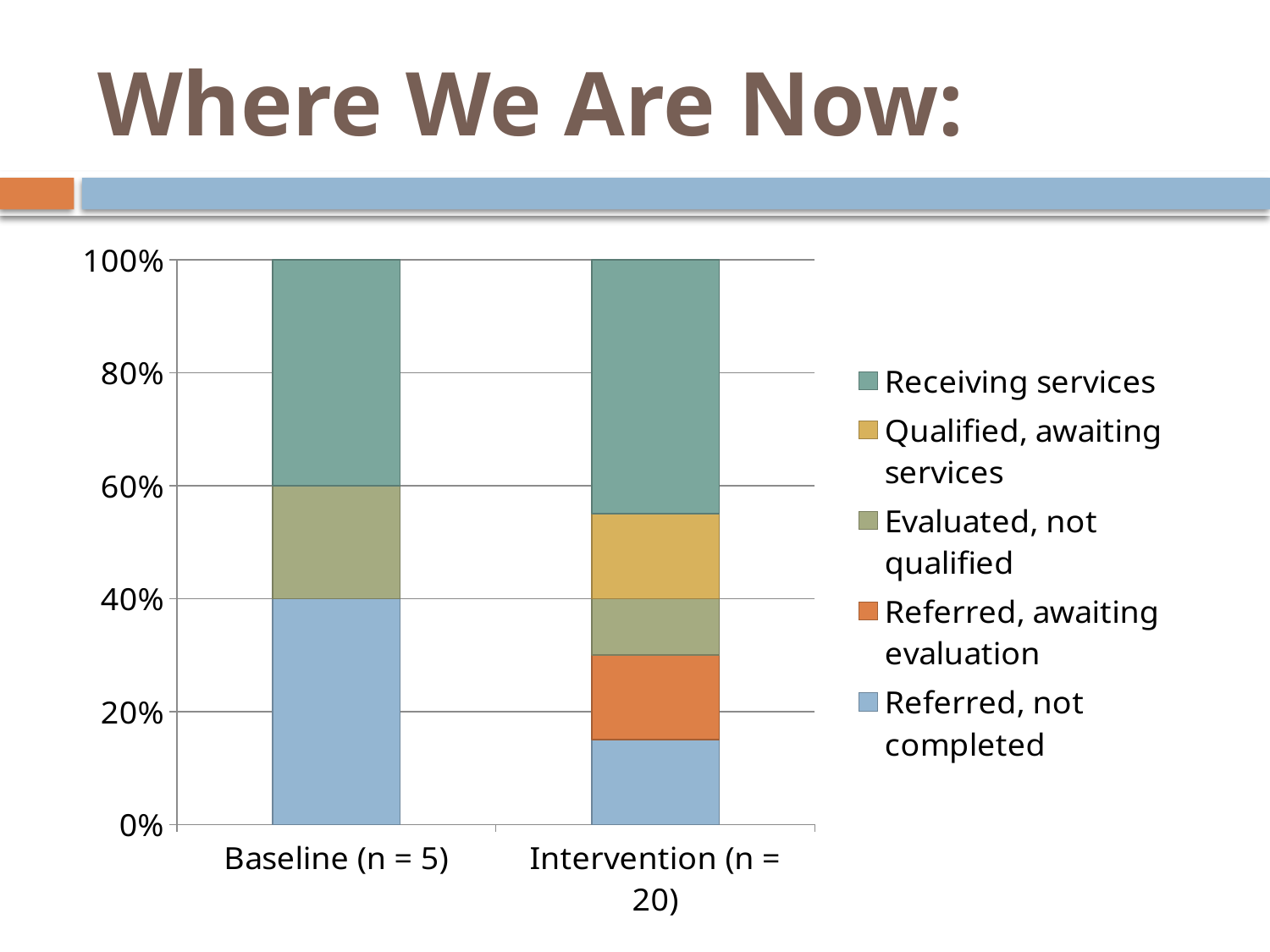
Is the value for Receiving services in the Intervention (n = 20) bar greater or less than 40%? greater How many series does the chart's legend list? 5 Which two legend series do not appear in the Baseline (n = 5) bar? Qualified, awaiting services and Referred, awaiting evaluation Which bar has the larger share for Referred, not completed: Baseline (n = 5) or Intervention (n = 20)? Baseline (n = 5) Which series makes up the largest share of the Intervention (n = 20) bar? Receiving services What is the title of the slide containing the chart? Where We Are Now: What is the value for Referred, not completed in the Baseline (n = 5) bar? 40% What kind of chart is shown on the slide? Stacked bar chart Is the value for Referred, awaiting evaluation in the Intervention (n = 20) bar greater or less than 20%? less Is the value for Referred, not completed in the Intervention (n = 20) bar greater or less than 20%? less How many categories are shown on the x axis of the chart? 2